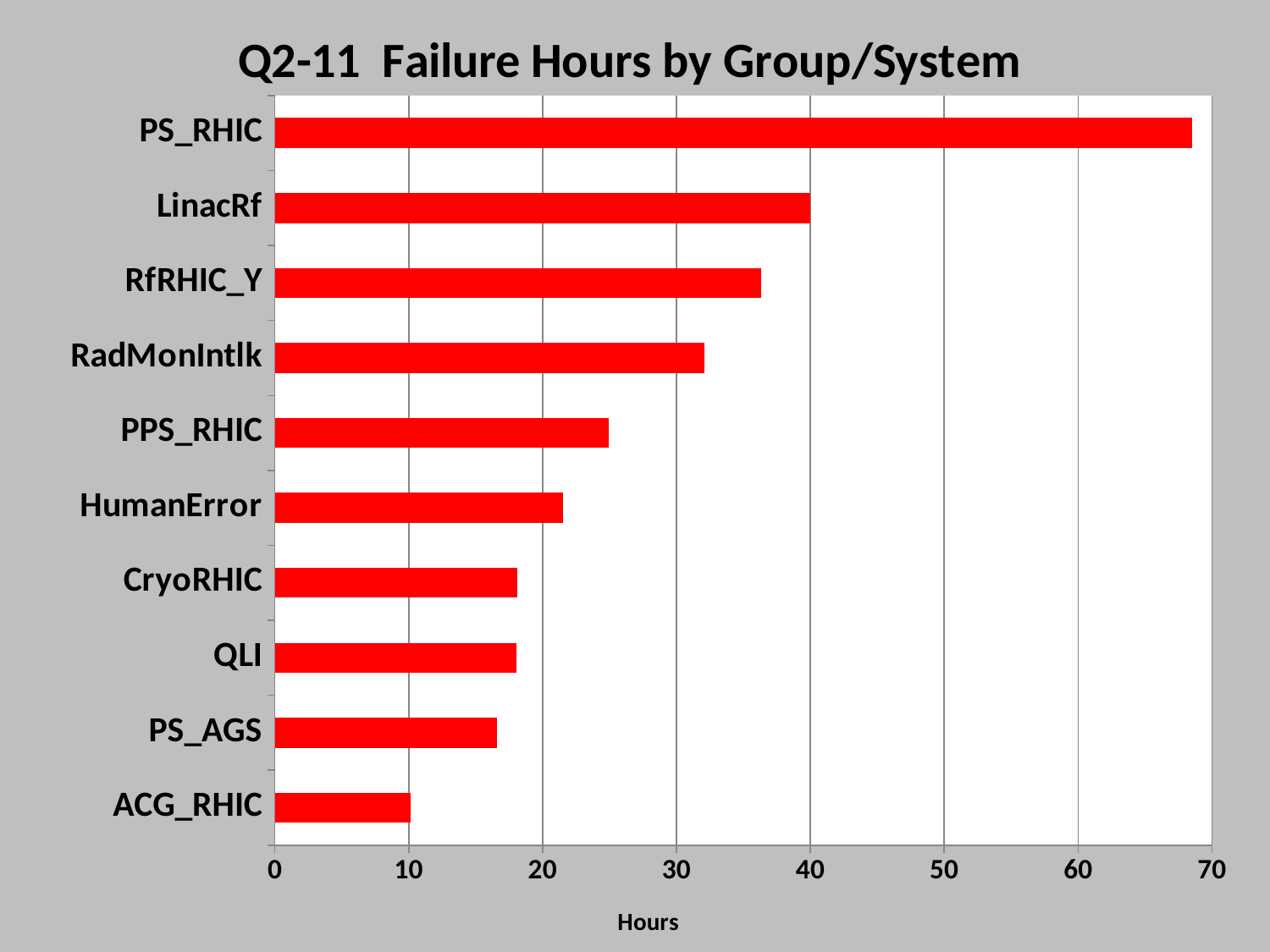
What kind of chart is shown on the slide? bar chart Which has more failure hours, RadMonIntlk or PPS_RHIC? RadMonIntlk How many groups/systems are plotted in the chart? 10 Which group/system has the highest failure hours? PS_RHIC Is the value for PS_AGS greater or less than 20? less Which group/system has the lowest failure hours? ACG_RHIC Is the value for HumanError greater or less than 20? greater What is the label on the horizontal axis? Hours Is the value for PS_RHIC greater or less than 60? greater What is the title of the chart? Q2-11 Failure Hours by Group/System